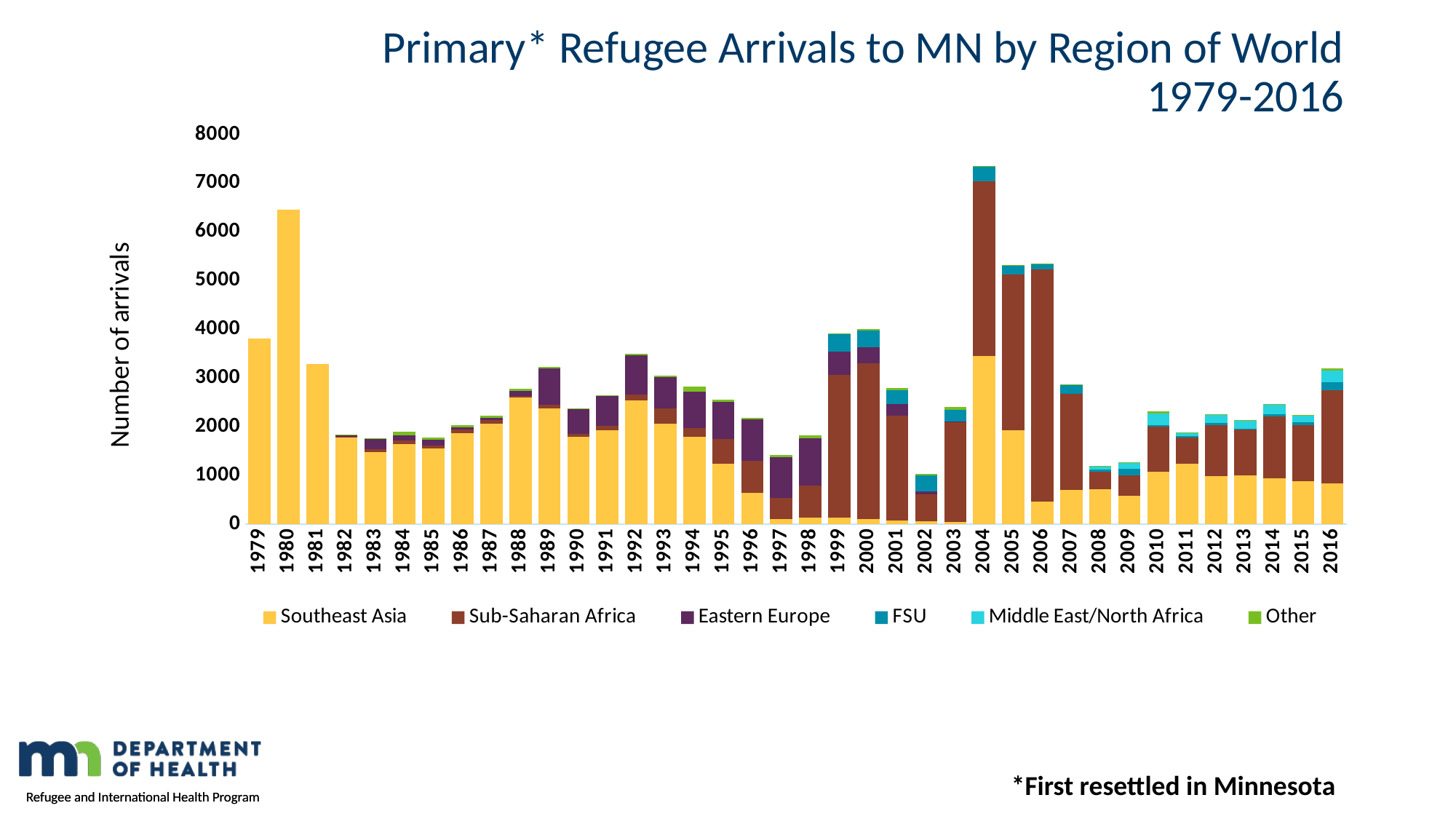
What is the label on the y axis? Number of arrivals What kind of chart is shown on the slide? Stacked bar chart Which year has a larger total number of arrivals, 1980 or 2004? 2004 How many series does the legend list? 6 Is the total number of arrivals in 2004 greater or less than 7000? greater How many years are shown along the x axis? 38 Which year has the highest total number of arrivals? 2004 Is the total number of arrivals in 1990 greater or less than 3000? less Which year has the lowest total number of arrivals? 2002 Do the total arrivals rise or fall from 2004 to 2009? fall Is the total number of arrivals in 1979 greater or less than 4000? less